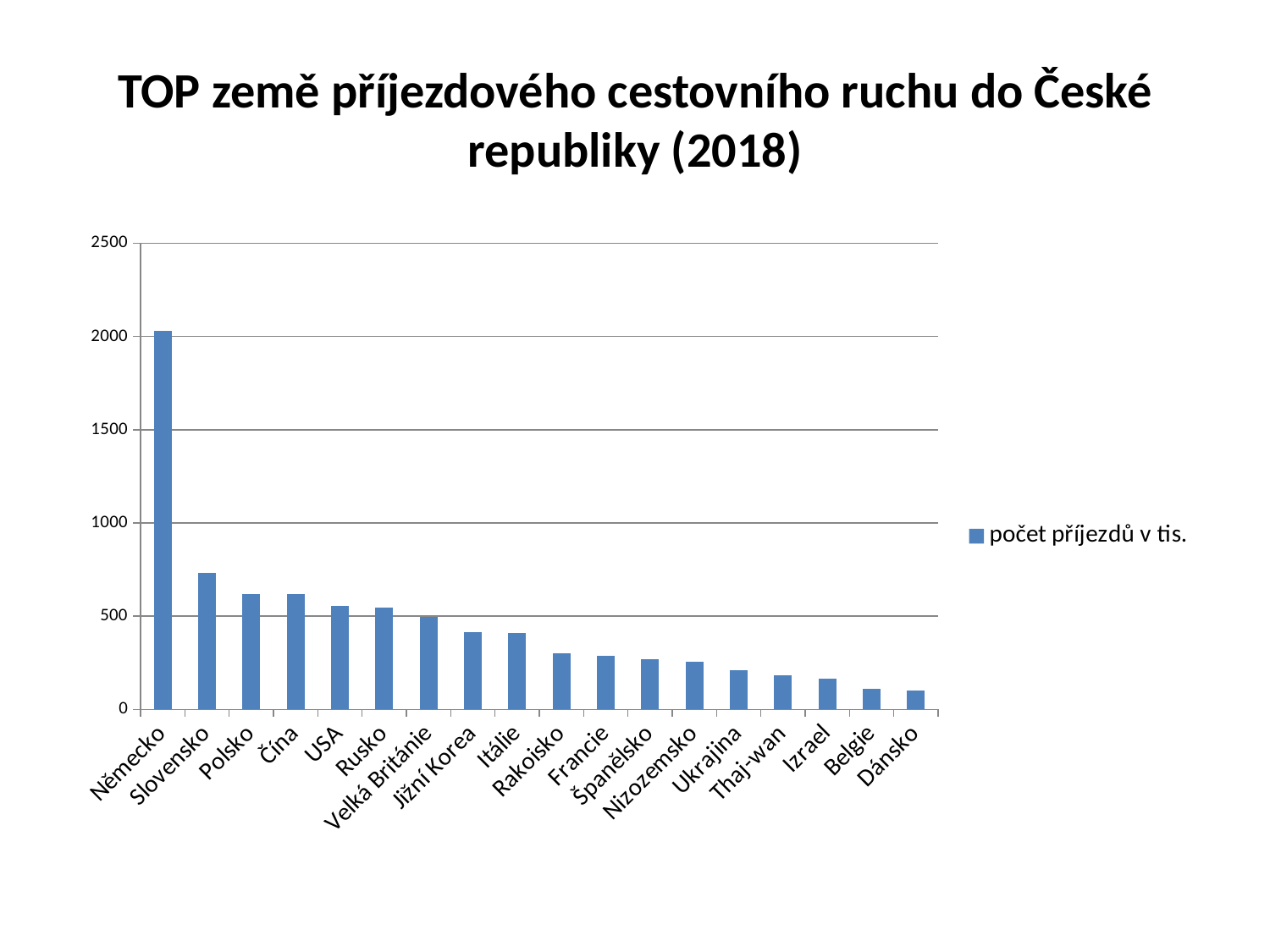
Is the value for Německo greater or less than 1500? greater Is the value for Slovensko greater or less than 1000? less Which has a larger value, Německo or Slovensko? Německo Is the value for Dánsko greater or less than 500? less How many countries are shown on the x axis of the chart? 18 How many series does the legend list? 1 Which country has the highest number of arrivals in the chart? Německo What kind of chart is shown on the slide? bar chart Do the values rise or fall from left to right along the x axis? fall